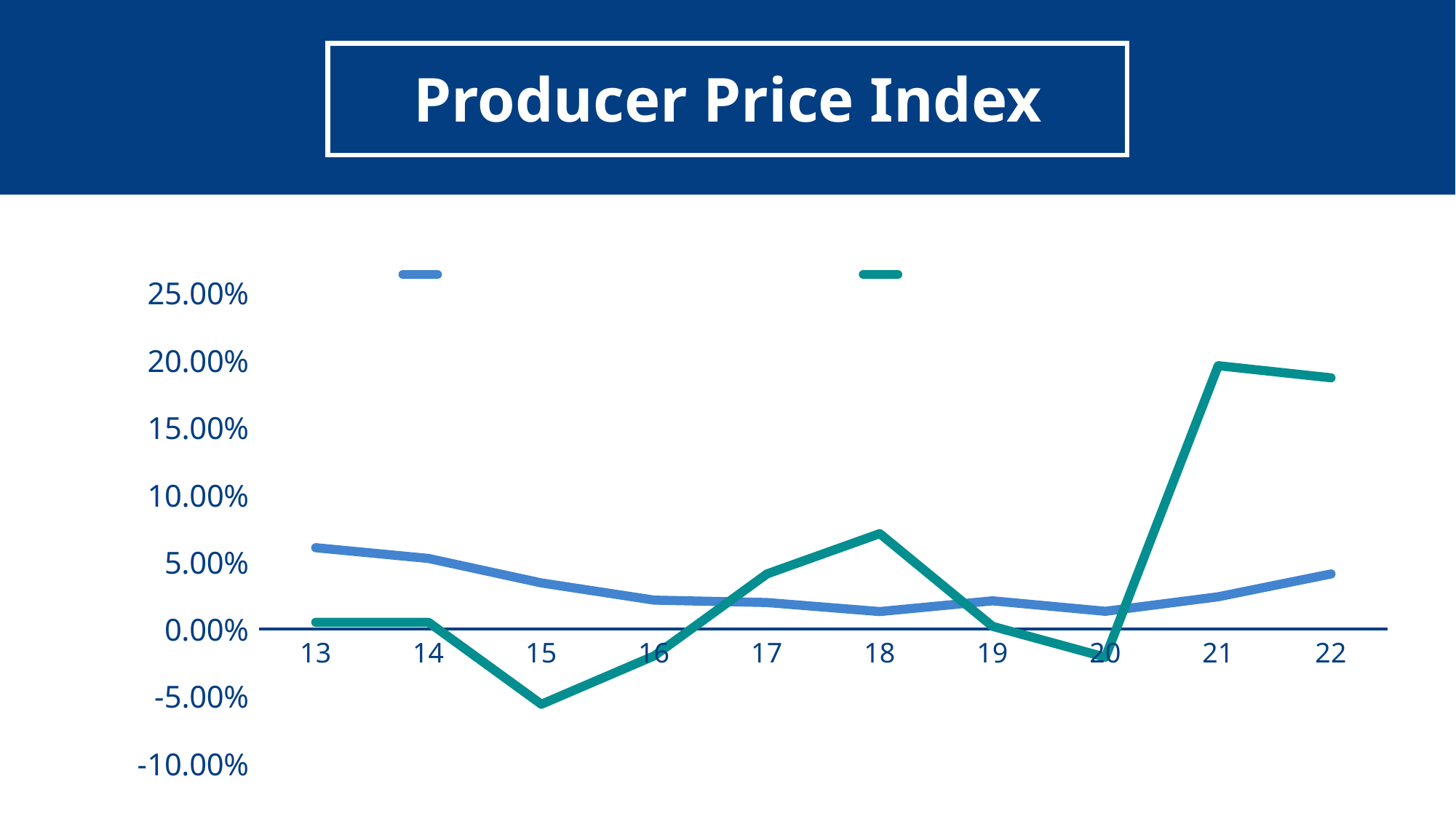
Is the value of the teal line at 15 greater or less than 0.00%? less What kind of chart is shown on the slide? line chart How many points are plotted along the x axis for each line? 10 Is the value of the teal line at 18 greater or less than 5.00%? greater Is the value of the teal line at 21 greater or less than 15.00%? greater Does the blue line rise or fall from 13 to 16? fall At 21, which line has the larger value, the blue line or the teal line? teal line How many series does the legend list? 2 At which x-axis point does the teal line reach its lowest value? 15 What is the title of the slide? Producer Price Index At which x-axis point does the teal line reach its highest value? 21